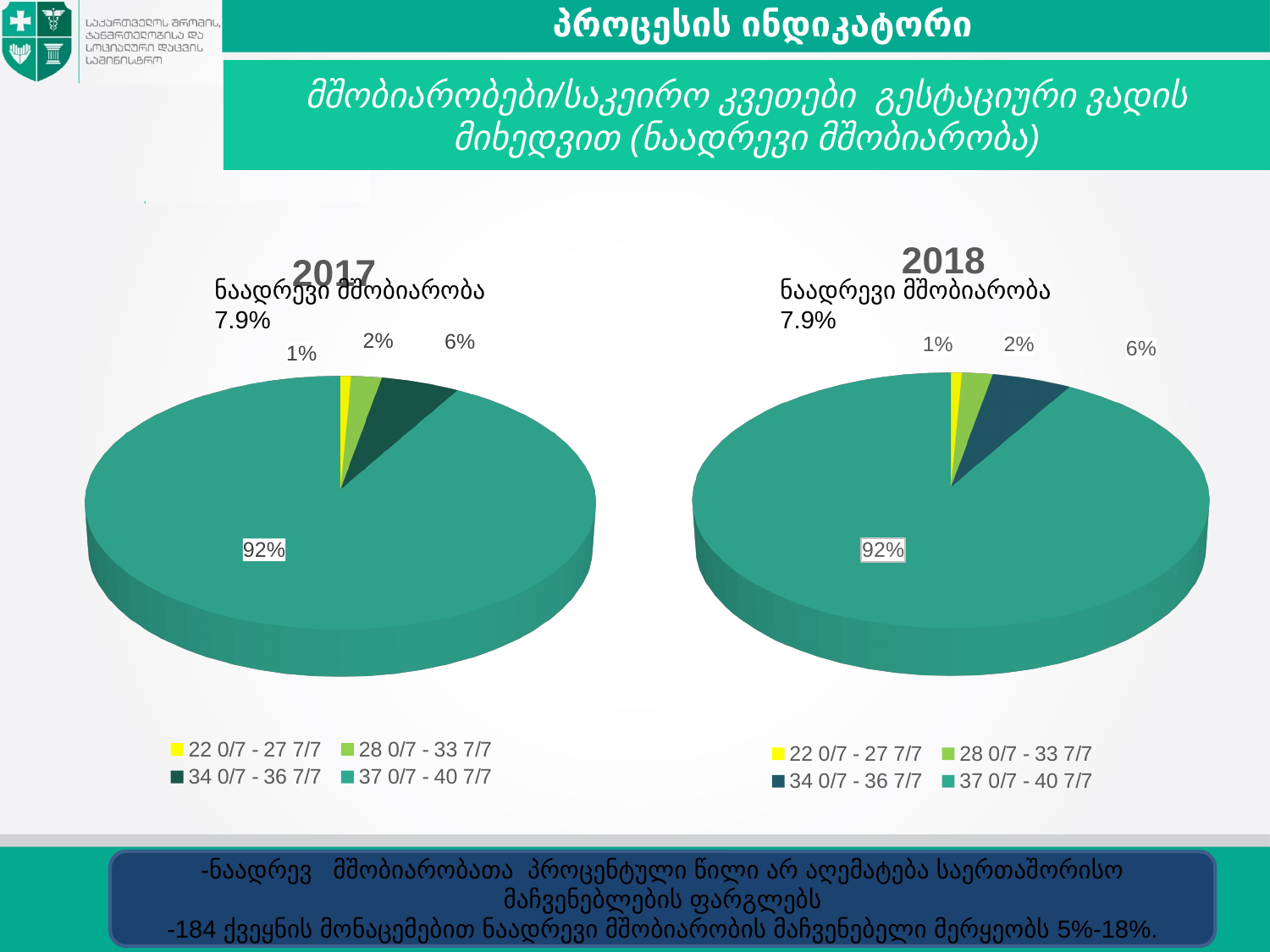
In the 2018 pie chart, which is larger: the 34 0/7 - 36 7/7 slice or the 28 0/7 - 33 7/7 slice? 34 0/7 - 36 7/7 How many slices does the 2018 pie chart have? 4 In the 2017 pie chart, which category has the largest share? 37 0/7 - 40 7/7 What year is shown as the title of the chart on the right? 2018 What type of chart is used for the 2017 data? Pie chart In the 2017 pie chart, what percentage is shown for the 37 0/7 - 40 7/7 slice? 92% In the 2017 pie chart, what is the difference between the 34 0/7 - 36 7/7 slice and the 28 0/7 - 33 7/7 slice? 4% In the 2018 pie chart, what percentage is shown for the 34 0/7 - 36 7/7 slice? 6% How many entries does the legend of the 2017 chart list? 4 In the 2017 pie chart, what percentage is shown for the 22 0/7 - 27 7/7 slice? 1% In the 2018 pie chart, what percentage is shown for the 28 0/7 - 33 7/7 slice? 2% In the 2018 pie chart, which category has the smallest share? 22 0/7 - 27 7/7